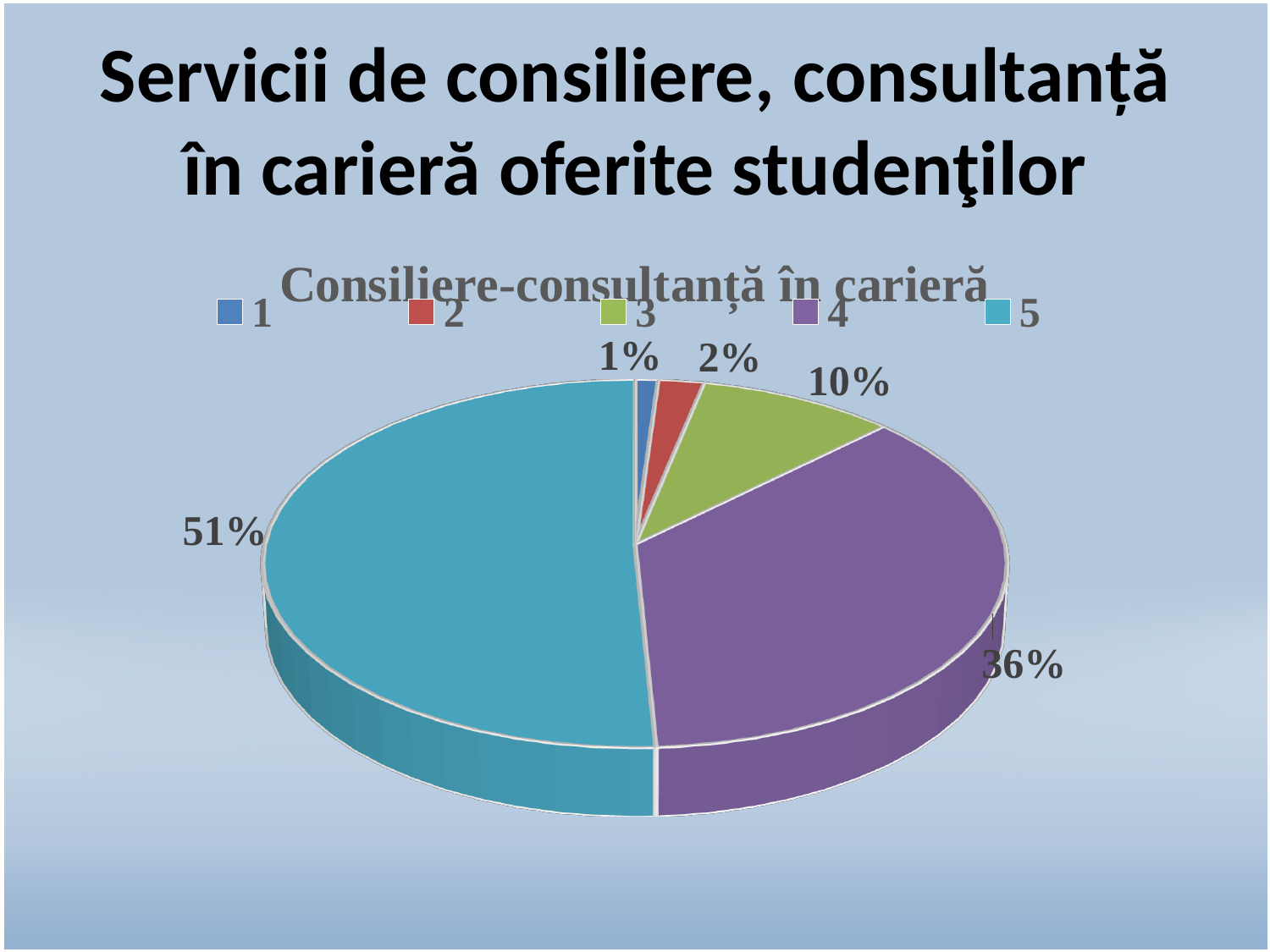
What is the difference between the shares of category 5 and category 4? 15% What is the chart's title? Consiliere-consultanță în carieră What share of the pie does category 3 have? 10% Which category has the largest slice? 5 What share of the pie does category 2 have? 2% Which is larger, the share of category 3 or the share of category 2? 3 What share of the pie does category 1 have? 1% Which category has the smallest slice? 1 What type of chart is shown on the slide? pie chart How many categories does the legend list? 5